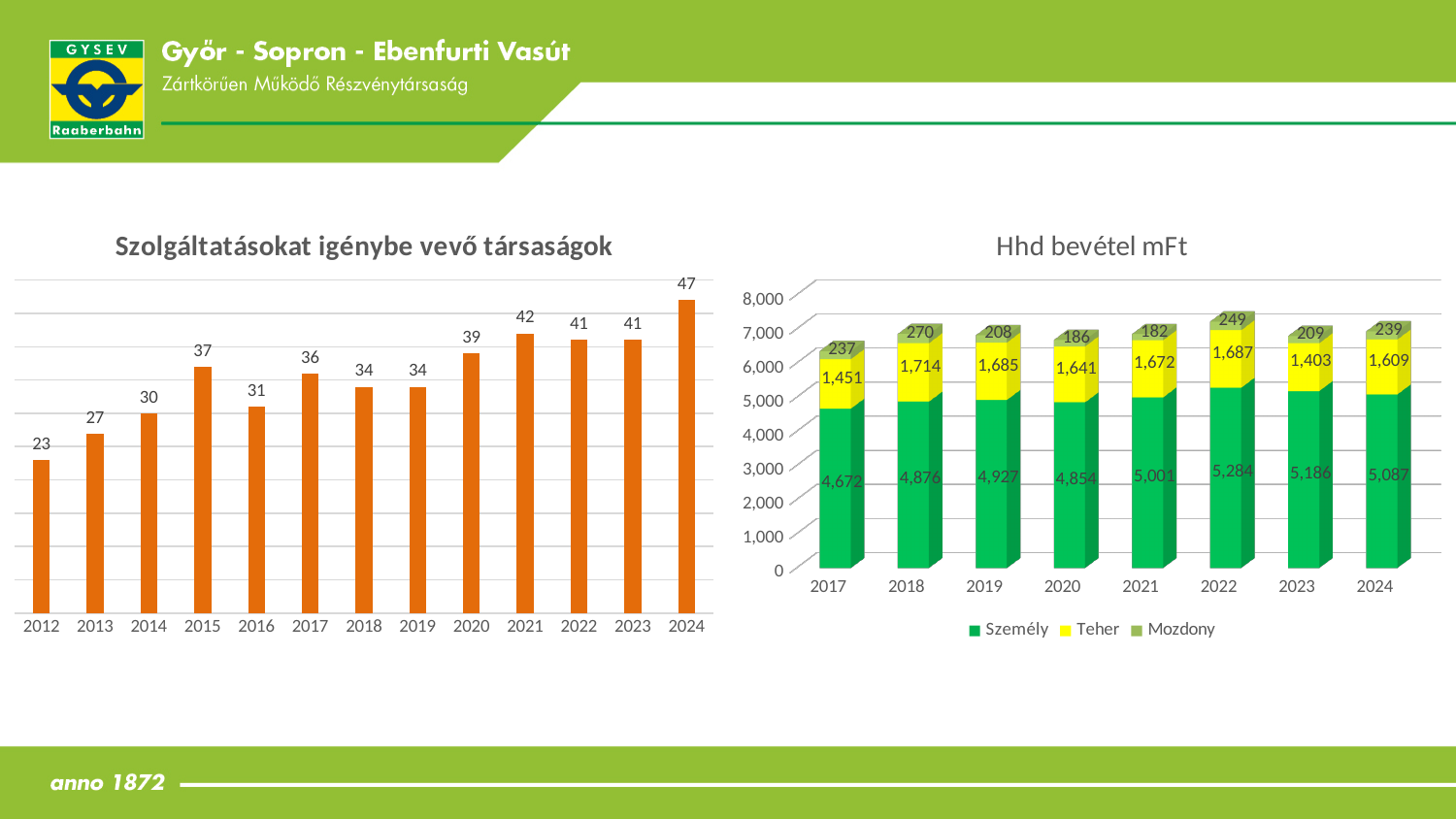
In the 'Hhd bevétel mFt' chart, what is the total of the stacked bar for 2017? 6,360 In the 'Szolgáltatásokat igénybe vevő társaságok' chart, how many years are shown on the x axis? 13 In the 'Hhd bevétel mFt' chart, how many series does the legend list? 3 In the 'Hhd bevétel mFt' chart, which is larger, the Mozdony value for 2018 or for 2021? 2018 In the 'Szolgáltatásokat igénybe vevő társaságok' chart, which year has the lowest value? 2012 In the 'Szolgáltatásokat igénybe vevő társaságok' chart, what is the value for 2015? 37 In the 'Hhd bevétel mFt' chart, what is the Teher value for 2018? 1,714 In the 'Hhd bevétel mFt' chart, what is the Személy value for 2022? 5,284 What kind of chart is 'Szolgáltatásokat igénybe vevő társaságok'? Bar chart In the 'Hhd bevétel mFt' chart, which year has the lowest Teher value? 2023 In the 'Szolgáltatásokat igénybe vevő társaságok' chart, what is the difference between the values for 2024 and 2012? 24 In the 'Szolgáltatásokat igénybe vevő társaságok' chart, which year has the highest value? 2024